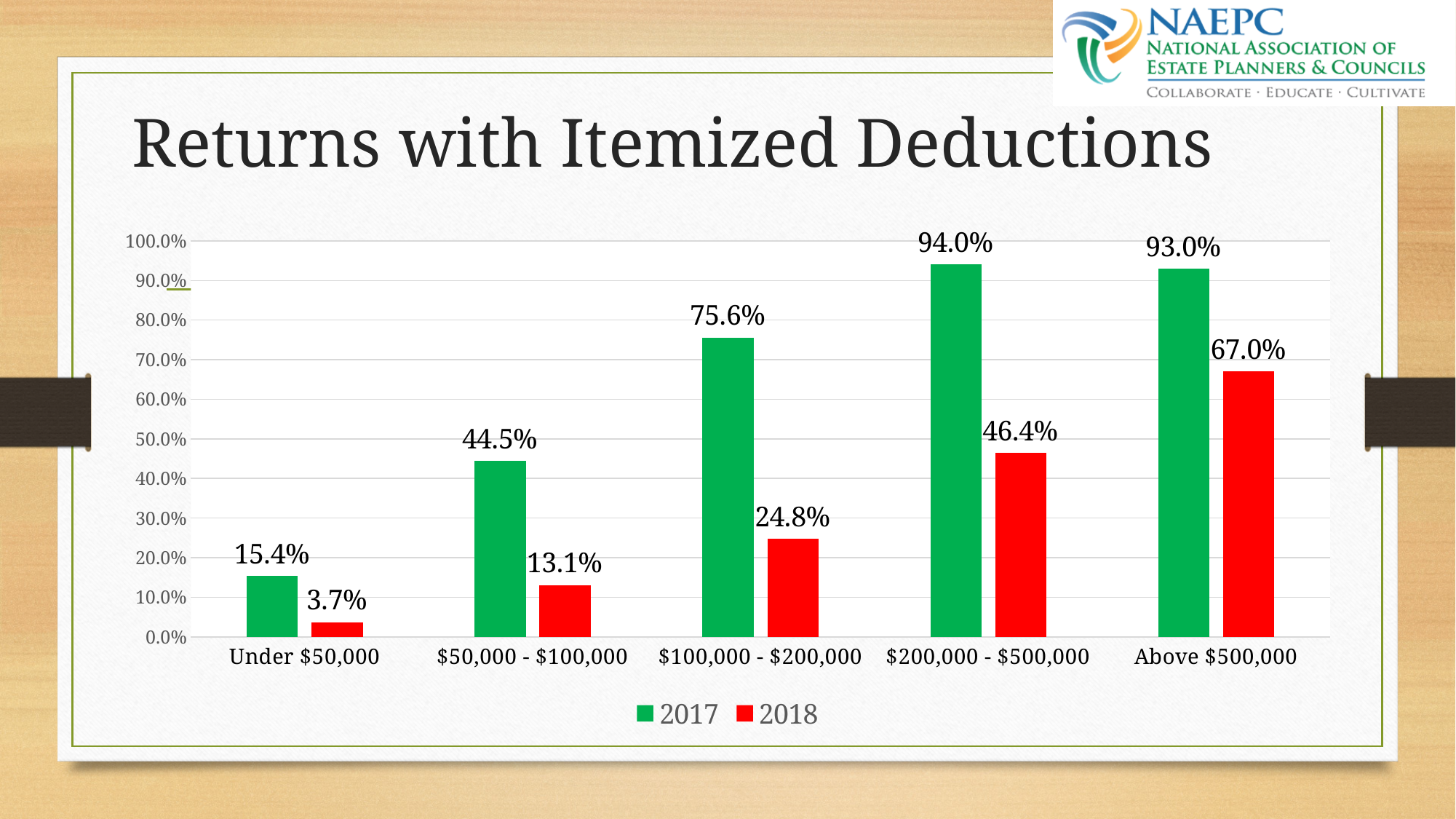
What is the 2017 value for the $100,000 - $200,000 income group? 75.6% How many series does the legend list? 2 Do the 2018 values rise or fall as income groups increase from left to right? Rise What is the difference between the 2017 and 2018 values for the $200,000 - $500,000 income group? 47.6% Which colour represents the 2018 series in the legend? Red Which income group has the highest 2017 value? $200,000 - $500,000 How many income groups are shown on the x axis? 5 Which income group has the lowest 2018 value? Under $50,000 Which is larger: the 2018 value for $50,000 - $100,000 or the 2018 value for $100,000 - $200,000? $100,000 - $200,000 What is the 2018 value for the Above $500,000 income group? 67.0% What kind of chart is shown on the slide? Bar chart What is the 2018 value for the Under $50,000 income group? 3.7%